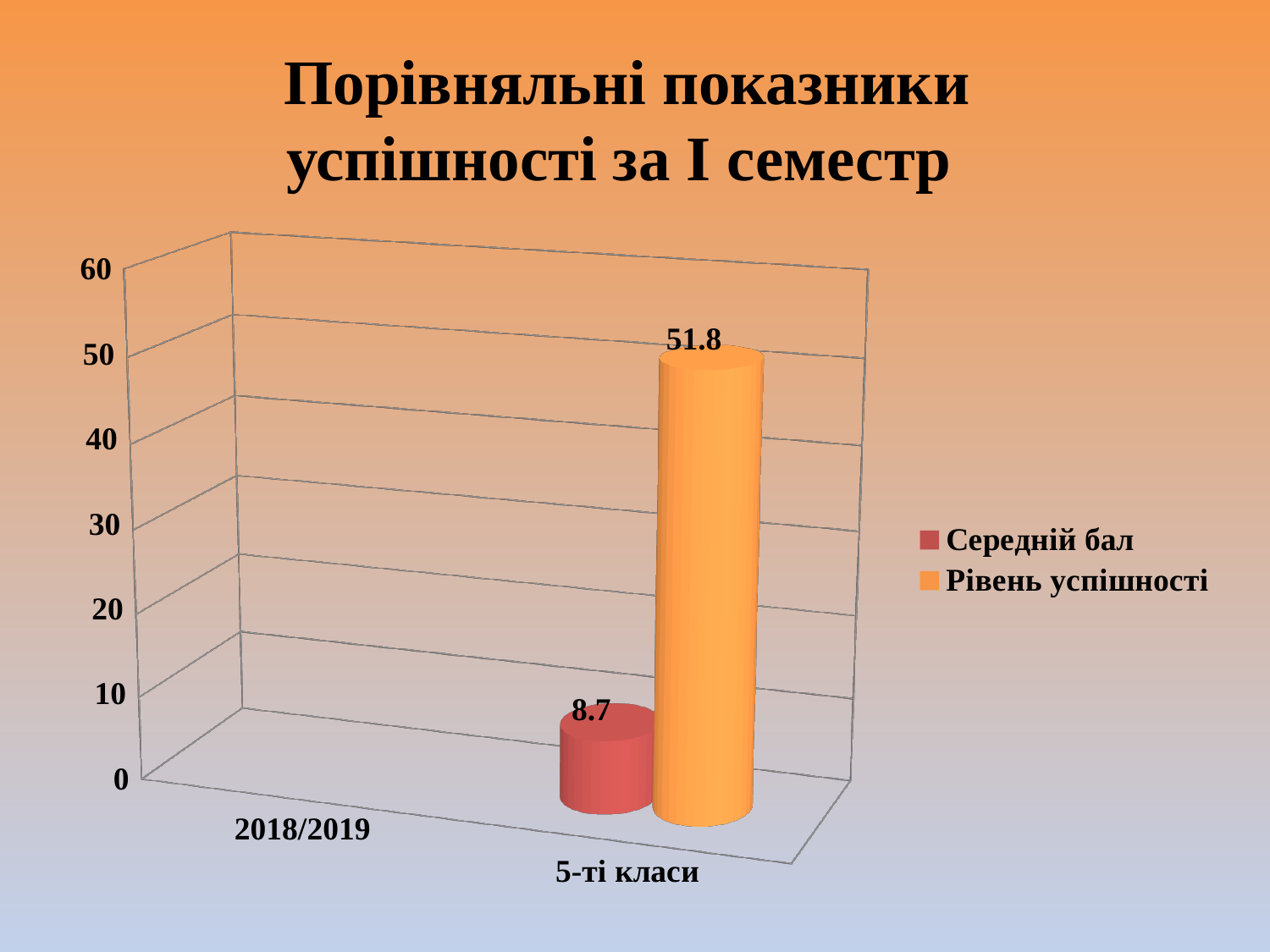
What is the value of Середній бал for 5-ті класи? 8.7 What is the highest value shown on the vertical axis? 60 What kind of chart is shown on the slide? bar chart What is the difference between Рівень успішності and Середній бал for 5-ті класи? 43.1 How many series does the legend list? 2 How many categories are shown on the x axis of the chart? 2 What is the title of the chart on the slide? Порівняльні показники успішності за І семестр Is the value for Рівень успішності greater or less than 50? greater What is the value of Рівень успішності for 5-ті класи? 51.8 What colour is the bar for Рівень успішності? orange Is the value for Середній бал greater or less than 10? less Which series has the higher value for 5-ті класи, Середній бал or Рівень успішності? Рівень успішності